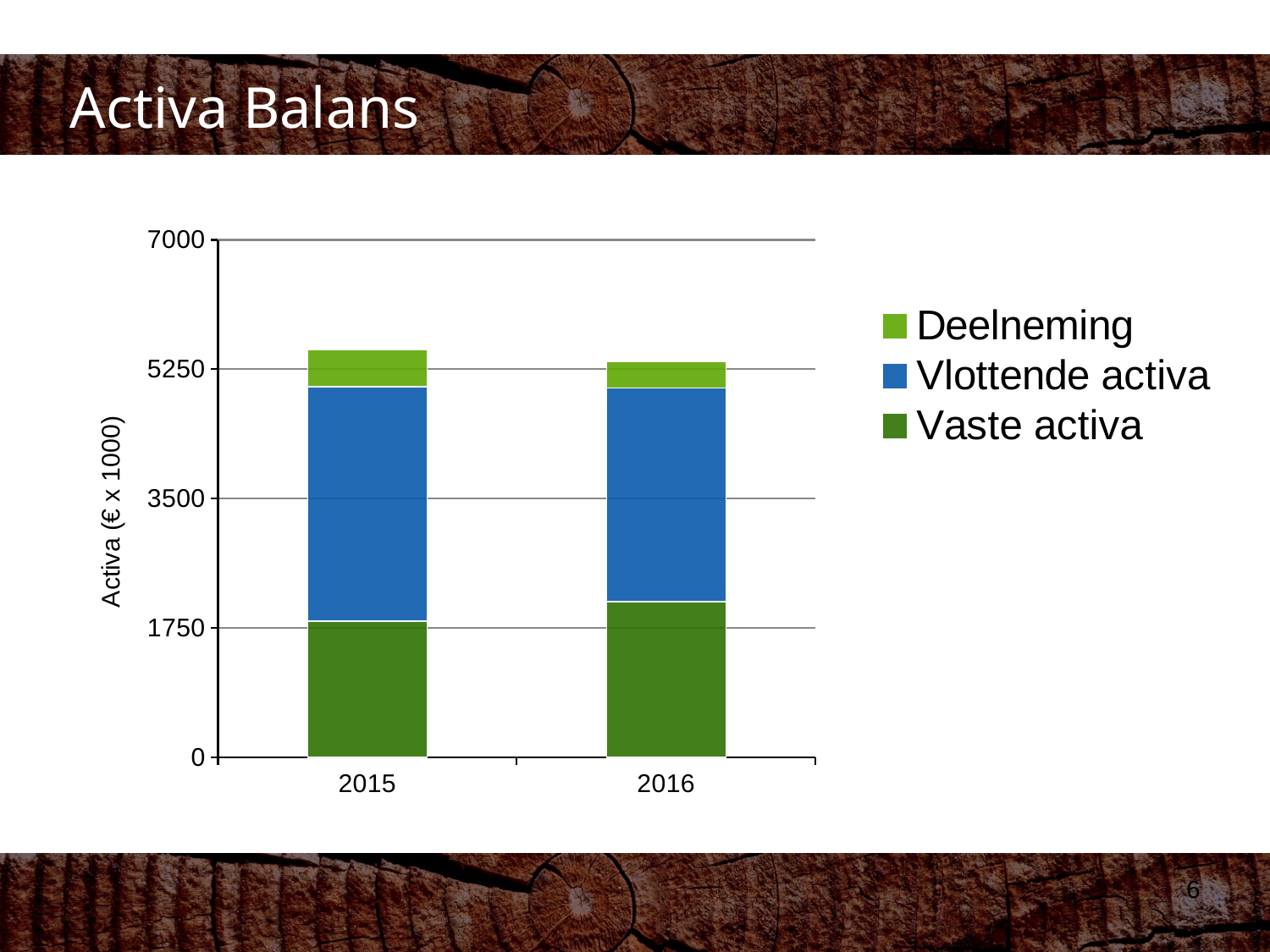
Which year has the larger Deelneming segment, 2015 or 2016? 2015 What is the label of the vertical axis of the chart? Activa (€ x 1000) Which series are listed in the chart's legend? Deelneming, Vlottende activa, Vaste activa Which year has the larger Vaste activa value, 2015 or 2016? 2016 Is the Vaste activa value for 2016 greater or less than 1750? greater Is the Vaste activa value for 2016 greater or less than 3500? less Is the total height of the stacked bar for 2015 greater or less than 7000? less How many years are shown on the x axis of the chart? 2 Does the Vaste activa value rise or fall from 2015 to 2016? rise What kind of chart is shown on the slide? Stacked bar chart How many series does the chart's legend list? 3